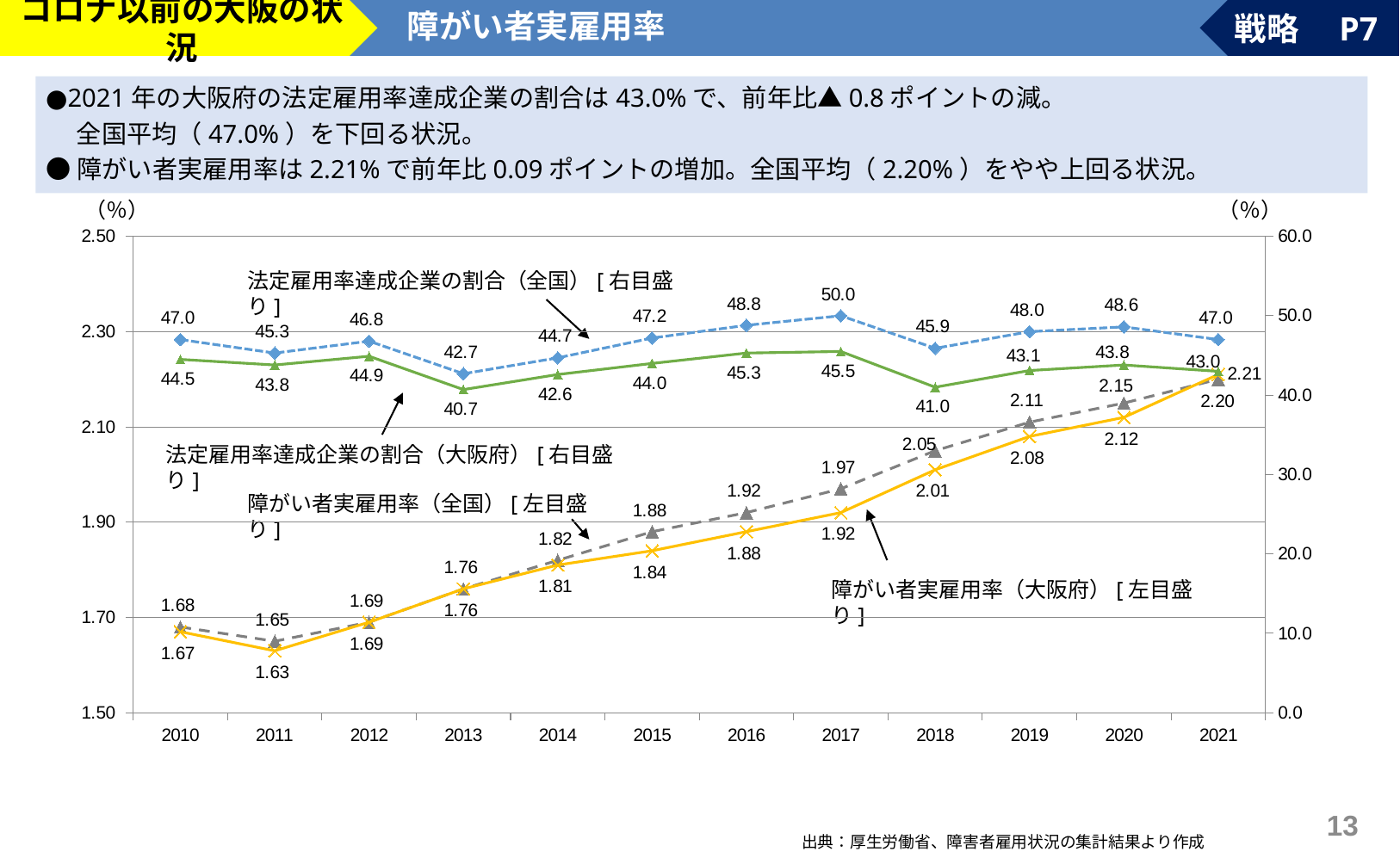
What is the value of 法定雇用率達成企業の割合（全国） in 2017? 50.0 In which year is 法定雇用率達成企業の割合（全国） highest? 2017 What is the difference between 法定雇用率達成企業の割合（全国） and 法定雇用率達成企業の割合（大阪府） in 2021? 4.0 What is the value of 障がい者実雇用率（大阪府） in 2018? 2.01 What is the value of 障がい者実雇用率（全国） in 2014? 1.82 Which is larger in 2016: 障がい者実雇用率（全国） or 障がい者実雇用率（大阪府）? 障がい者実雇用率（全国） Does 障がい者実雇用率（全国） generally rise or fall from 2011 to 2021? rise In which year is 障がい者実雇用率（大阪府） lowest? 2011 How many years are plotted along the x axis? 12 What is the value of 法定雇用率達成企業の割合（大阪府） in 2013? 40.7 What kind of chart is shown on the slide? line chart How many data series are labelled on the chart? 4